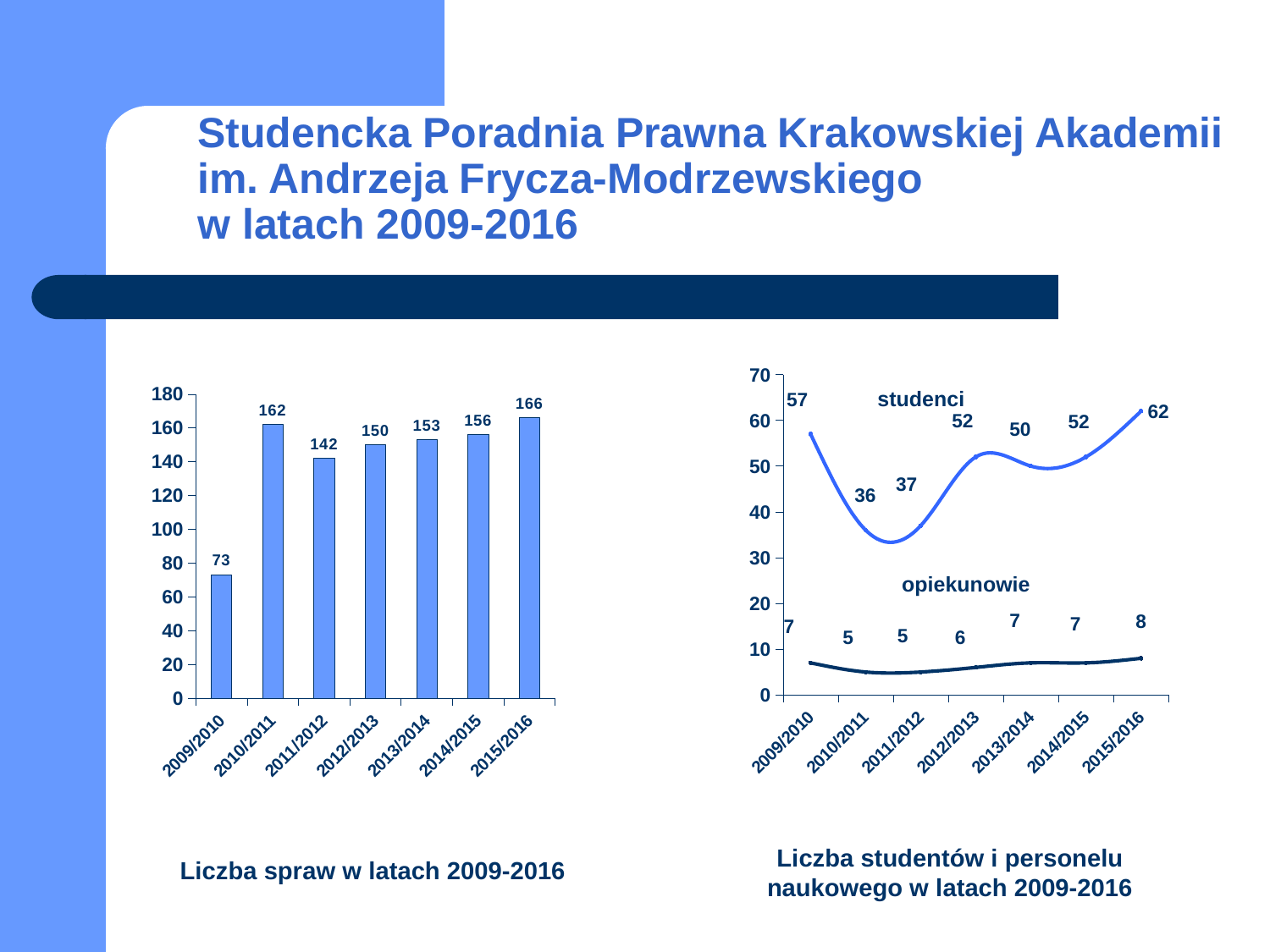
In the right chart (Liczba studentów i personelu naukowego w latach 2009-2016), in which year is the studenci value highest? 2015/2016 In the right chart (Liczba studentów i personelu naukowego w latach 2009-2016), what is the value for studenci in 2010/2011? 36 What kind of chart is the right chart (Liczba studentów i personelu naukowego w latach 2009-2016)? line chart What kind of chart is the left chart (Liczba spraw w latach 2009-2016)? bar chart In the left chart (Liczba spraw w latach 2009-2016), what is the value for 2009/2010? 73 In the left chart (Liczba spraw w latach 2009-2016), which year has the lowest value? 2009/2010 In the right chart (Liczba studentów i personelu naukowego w latach 2009-2016), what is the value for opiekunowie in 2015/2016? 8 In the right chart (Liczba studentów i personelu naukowego w latach 2009-2016), what is the difference between studenci and opiekunowie in 2009/2010? 50 In the right chart (Liczba studentów i personelu naukowego w latach 2009-2016), how many series are plotted? 2 In the left chart (Liczba spraw w latach 2009-2016), how many years are shown on the x axis? 7 In the left chart (Liczba spraw w latach 2009-2016), which year has the highest value? 2015/2016 In the left chart (Liczba spraw w latach 2009-2016), what is the difference between the values for 2010/2011 and 2011/2012? 20